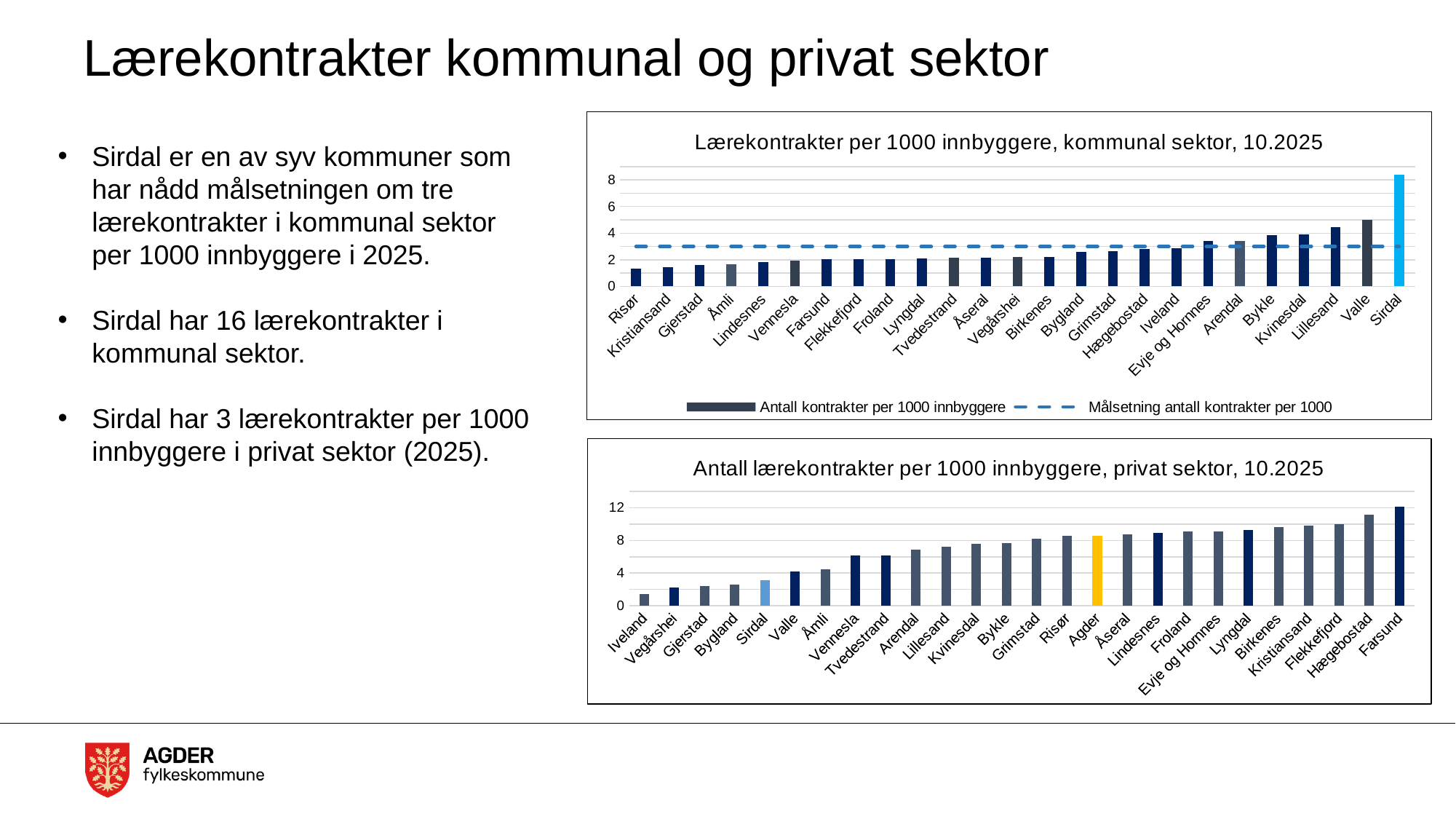
In the top chart (kommunal sektor), which municipality has the highest value? Sirdal How many entries does the legend of the top chart (kommunal sektor) list? 2 In the bottom chart (privat sektor), which category has the highest value? Farsund Do the values in the bottom chart (privat sektor) rise or fall from left to right along the x axis? Rise In the bottom chart (privat sektor), is the value for Vennesla greater or less than 4? greater How many municipalities are shown on the x axis of the top chart (kommunal sektor)? 25 In the bottom chart (privat sektor), which category has the lowest value? Iveland In the top chart (kommunal sektor), which is larger, the value for Valle or the value for Lillesand? Valle What kind of chart is the top chart, 'Lærekontrakter per 1000 innbyggere, kommunal sektor, 10.2025'? Combination bar and line chart (bars with a dashed target line) In the top chart (kommunal sektor), which municipality has the lowest value? Risør In the top chart (kommunal sektor), is the value for Sirdal greater or less than 8? greater In the top chart (kommunal sektor), is the value for Risør greater or less than 2? less